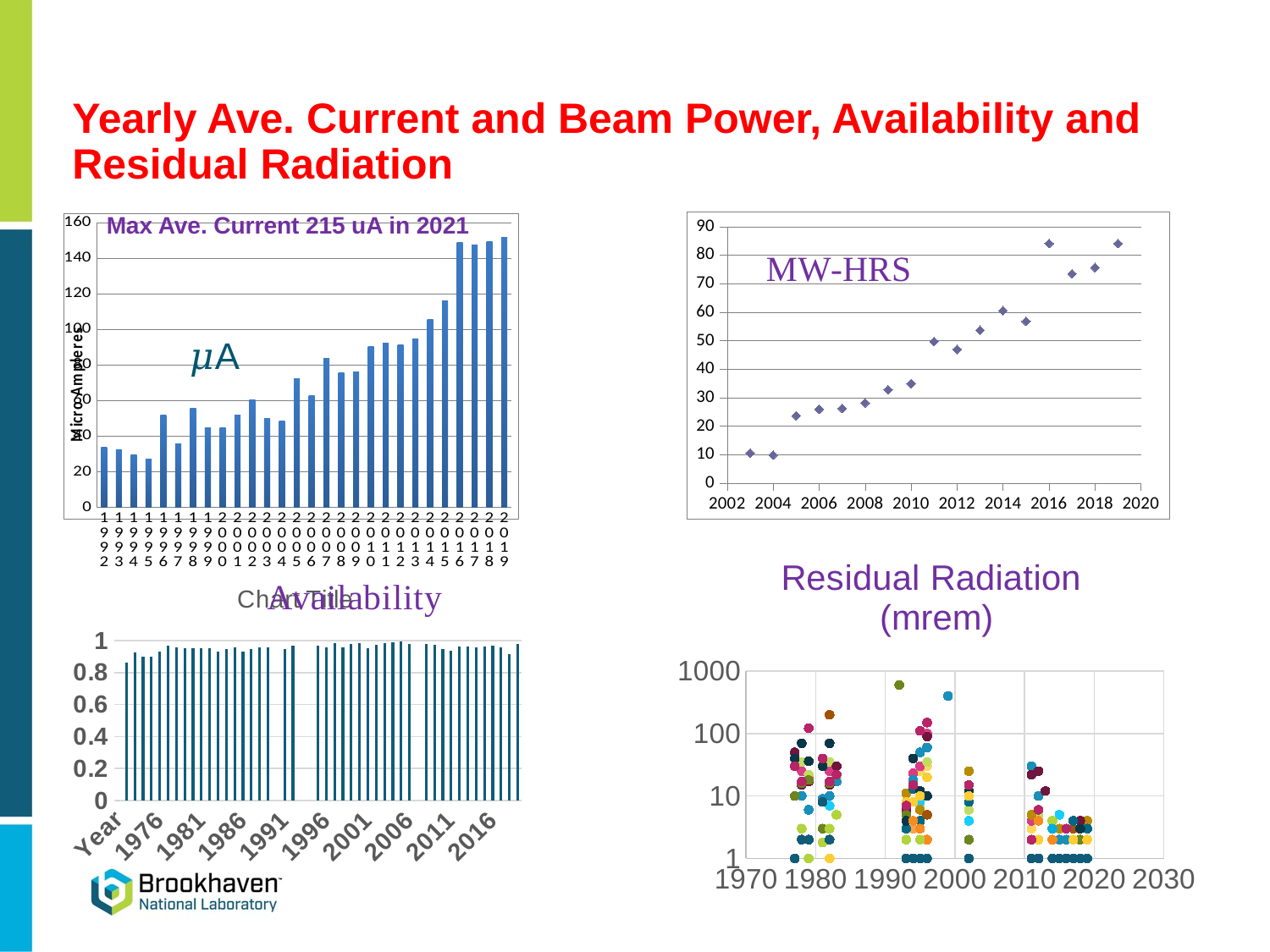
In the top-left Micro Amperes bar chart, do the values generally rise or fall from 1992 to 2019? rise What kind of chart is the top-left chart with the y-axis labelled Micro Amperes? bar chart In the top-right MW-HRS chart, is the value for 2016 greater or less than 80? greater In the top-right MW-HRS chart, do the values generally rise or fall from 2003 to 2019? rise In the top-left Micro Amperes bar chart, is the value for 1992 greater or less than 40? less In the top-left Micro Amperes bar chart, is the value for 2016 greater or less than 140? greater In the top-left Micro Amperes bar chart, which is larger, the value for 2019 or the value for 1992? 2019 What maximum average current does the annotation on the top-left chart state was reached in 2021? 215 uA What is the title of the bottom-right scatter chart? Residual Radiation (mrem) What kind of chart is the top-right MW-HRS chart? scatter chart In the top-left Micro Amperes bar chart, how many yearly bars are plotted? 28